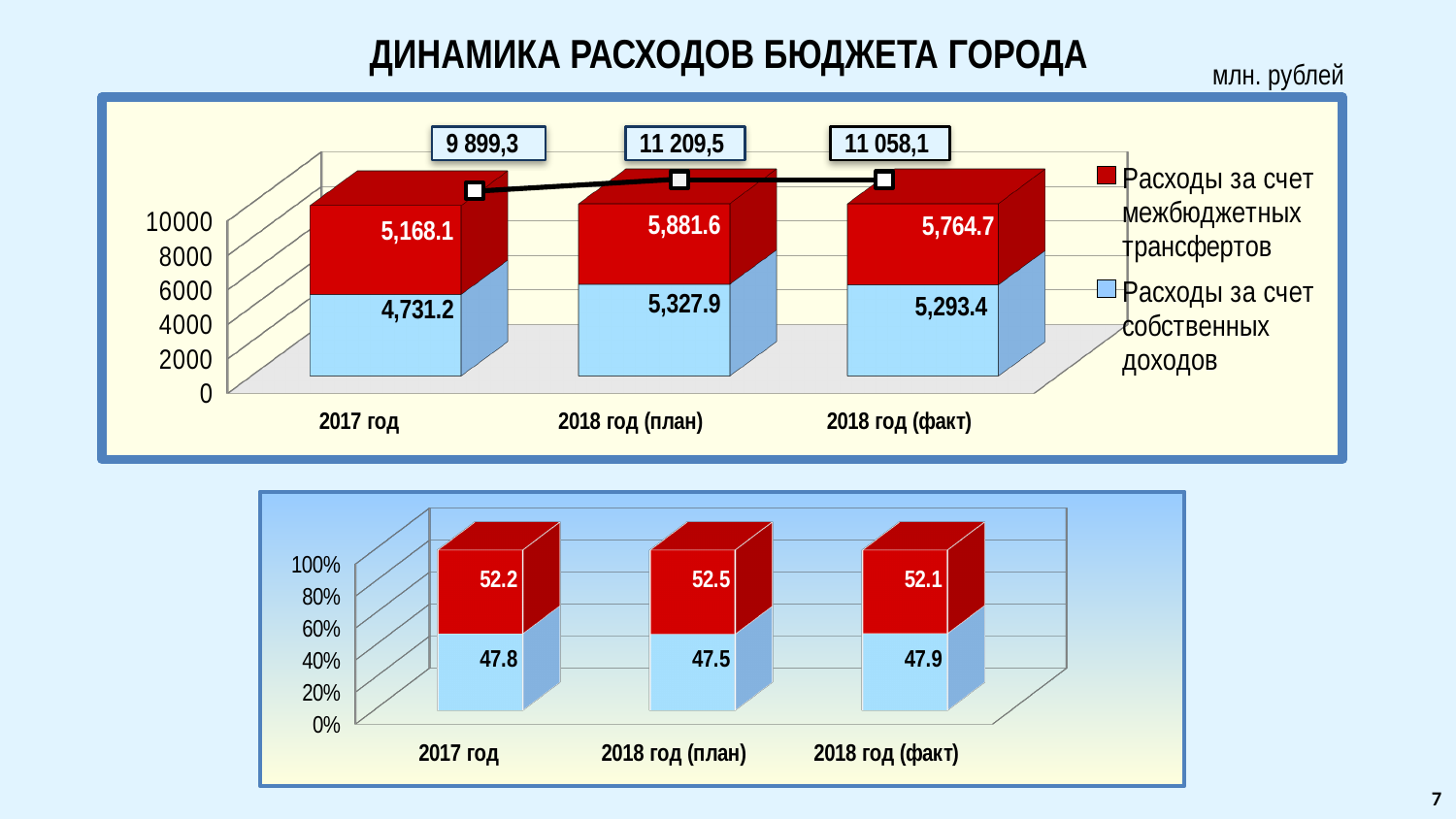
In the top chart, what is the difference between Расходы за счет межбюджетных трансфертов in 2018 год (план) and 2018 год (факт)? 116.9 In the top chart, which series is shown in red? Расходы за счет межбюджетных трансфертов In the bottom chart, what is the value of the red segment for 2018 год (план)? 52.5 In the top chart, how many series does the legend list? 2 In the top chart, what total is shown above the bar for 2018 год (факт)? 11 058,1 What kind of chart is the bottom chart? Stacked bar chart In the top chart, what is the value for Расходы за счет межбюджетных трансфертов in 2018 год (план)? 5,881.6 In the top chart, how many categories are shown on the x axis? 3 In the top chart, which category has the highest value for Расходы за счет межбюджетных трансфертов? 2018 год (план) In the top chart, what is the value for Расходы за счет собственных доходов in 2017 год? 4,731.2 In the bottom chart, which category has the highest value for the blue segment? 2018 год (факт) In the top chart, which category has the lowest value for Расходы за счет собственных доходов? 2017 год